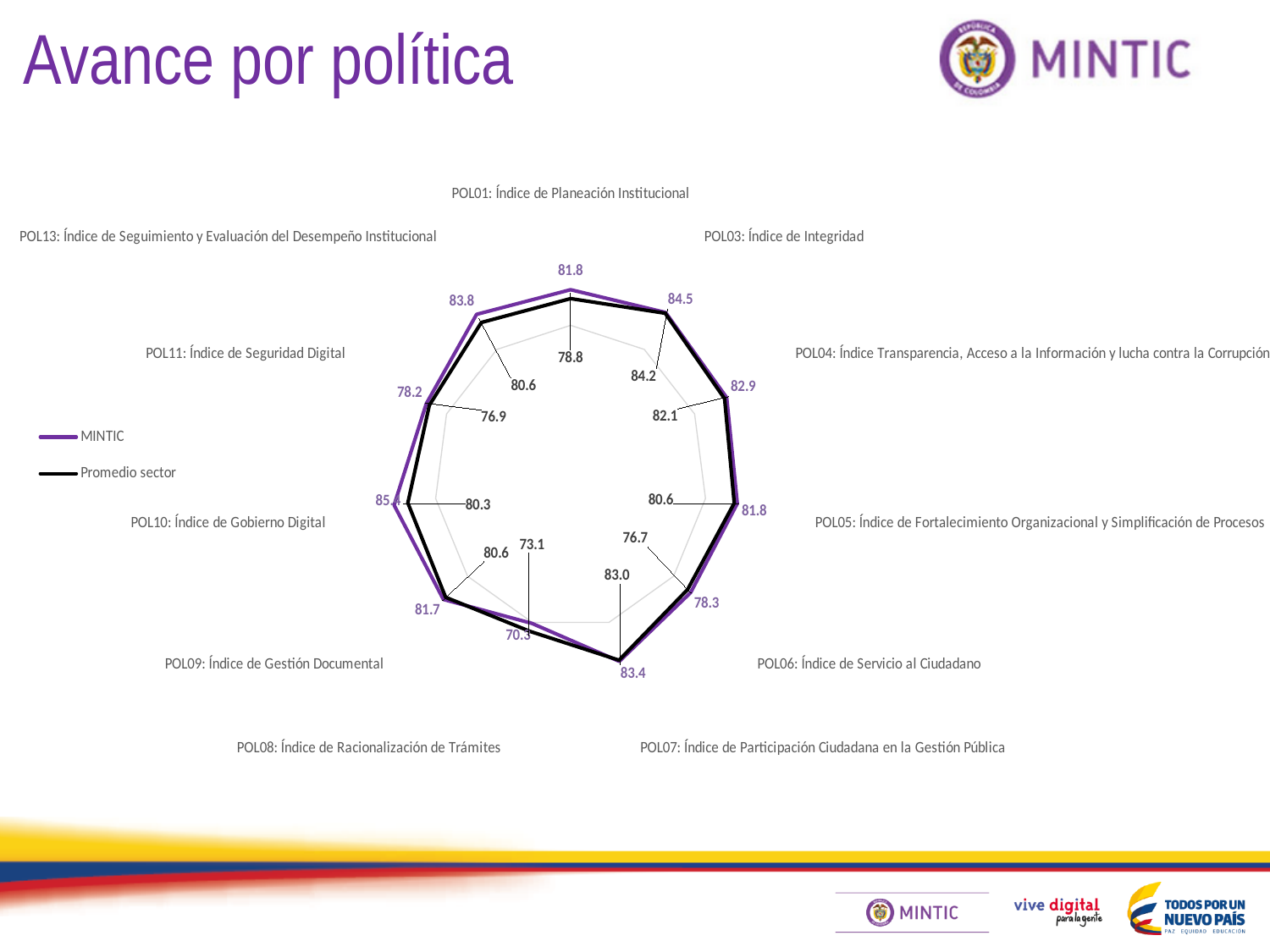
Which category has the highest Promedio sector value? POL03: Índice de Integridad What is the difference between the MINTIC and Promedio sector values for POL13: Índice de Seguimiento y Evaluación del Desempeño Institucional? 3.2 How many policy categories (axes) does the radar chart have? 11 For POL08: Índice de Racionalización de Trámites, which is larger, the MINTIC value or the Promedio sector value? Promedio sector How many series does the legend list? 2 What is the MINTIC value for POL01: Índice de Planeación Institucional? 81.8 What kind of chart is shown on the slide? radar chart What is the MINTIC value for POL03: Índice de Integridad? 84.5 What is the Promedio sector value for POL08: Índice de Racionalización de Trámites? 73.1 Which series is drawn in purple in the legend? MINTIC What is the Promedio sector value for POL06: Índice de Servicio al Ciudadano? 76.7 Which category has the lowest MINTIC value? POL08: Índice de Racionalización de Trámites